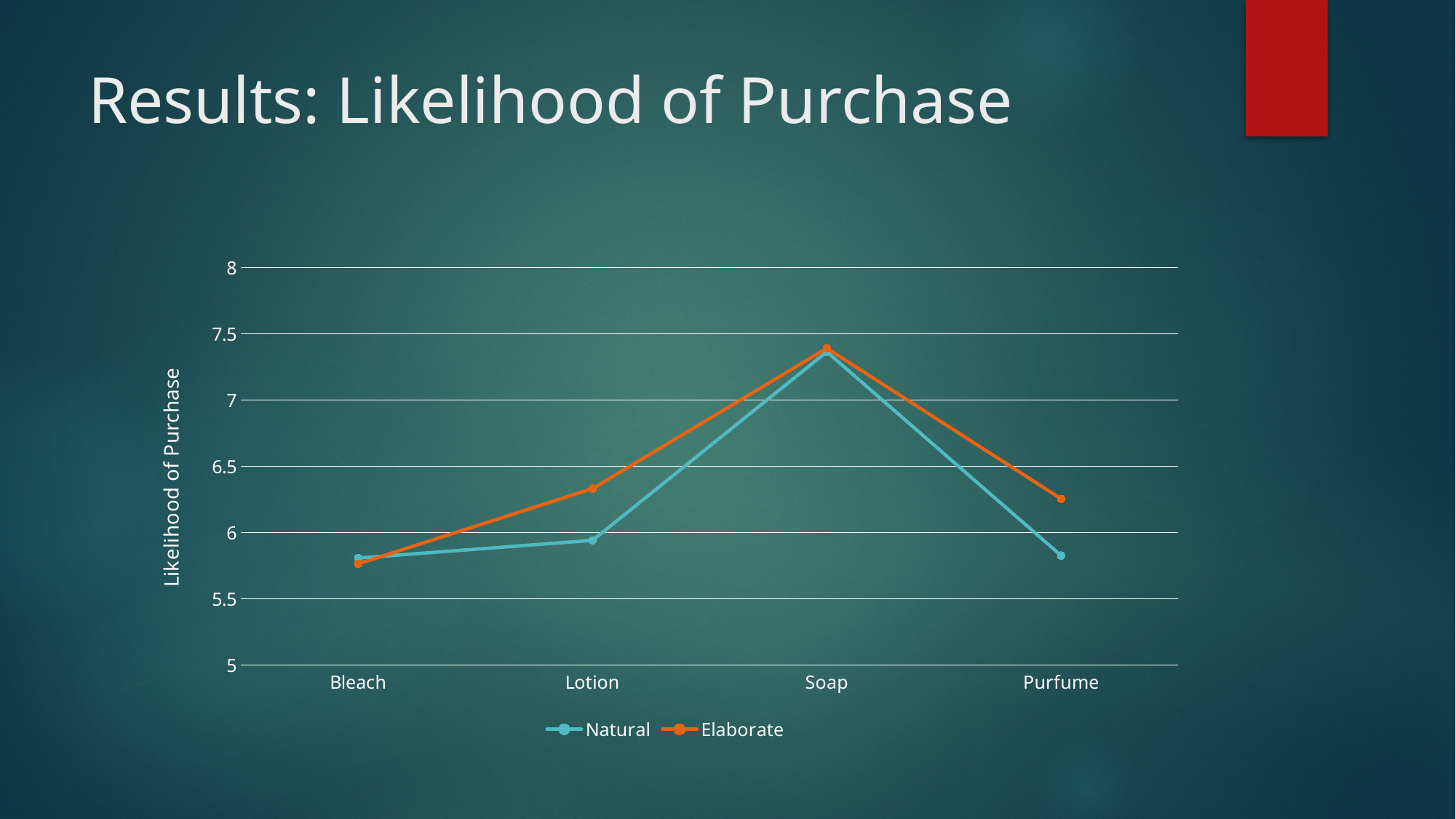
For Purfume, which series has the larger value, Natural or Elaborate? Elaborate How many series does the legend list? 2 Is the Natural value for Soap greater or less than 7? greater For the Natural series, which product has the highest likelihood of purchase? Soap For the Elaborate series, which product has the highest likelihood of purchase? Soap What is the title of the vertical axis? Likelihood of Purchase How many product categories are shown on the x axis? 4 Is the Natural value for Lotion greater or less than 6? less Is the Elaborate value for Lotion greater or less than 6? greater What kind of chart is shown on the slide? line chart For the Elaborate series, which product has the lowest likelihood of purchase? Bleach